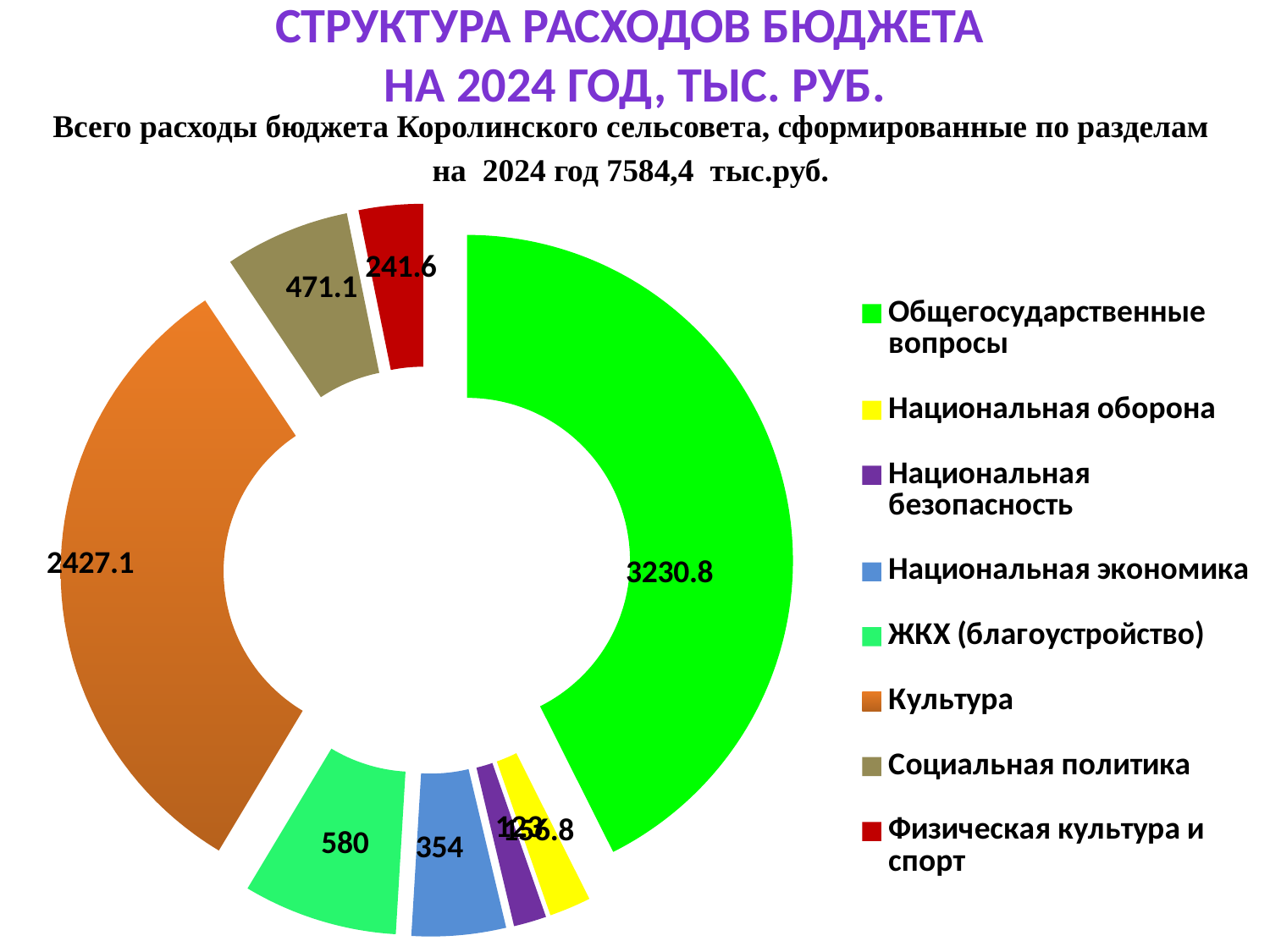
What value is shown for Физическая культура и спорт? 241.6 What kind of chart is shown on the slide? Doughnut (pie) chart Which is larger, Социальная политика or Физическая культура и спорт? Социальная политика What value is shown for Культура? 2427.1 What value is shown for Национальная экономика? 354 What is the difference between the values for ЖКХ (благоустройство) and Национальная экономика? 226 What value is shown for Общегосударственные вопросы? 3230.8 What value is shown for ЖКХ (благоустройство)? 580 How many categories does the chart show? 8 What value is shown for Социальная политика? 471.1 Which category has the largest value? Общегосударственные вопросы What is the difference between the values for Общегосударственные вопросы and Культура? 803.7